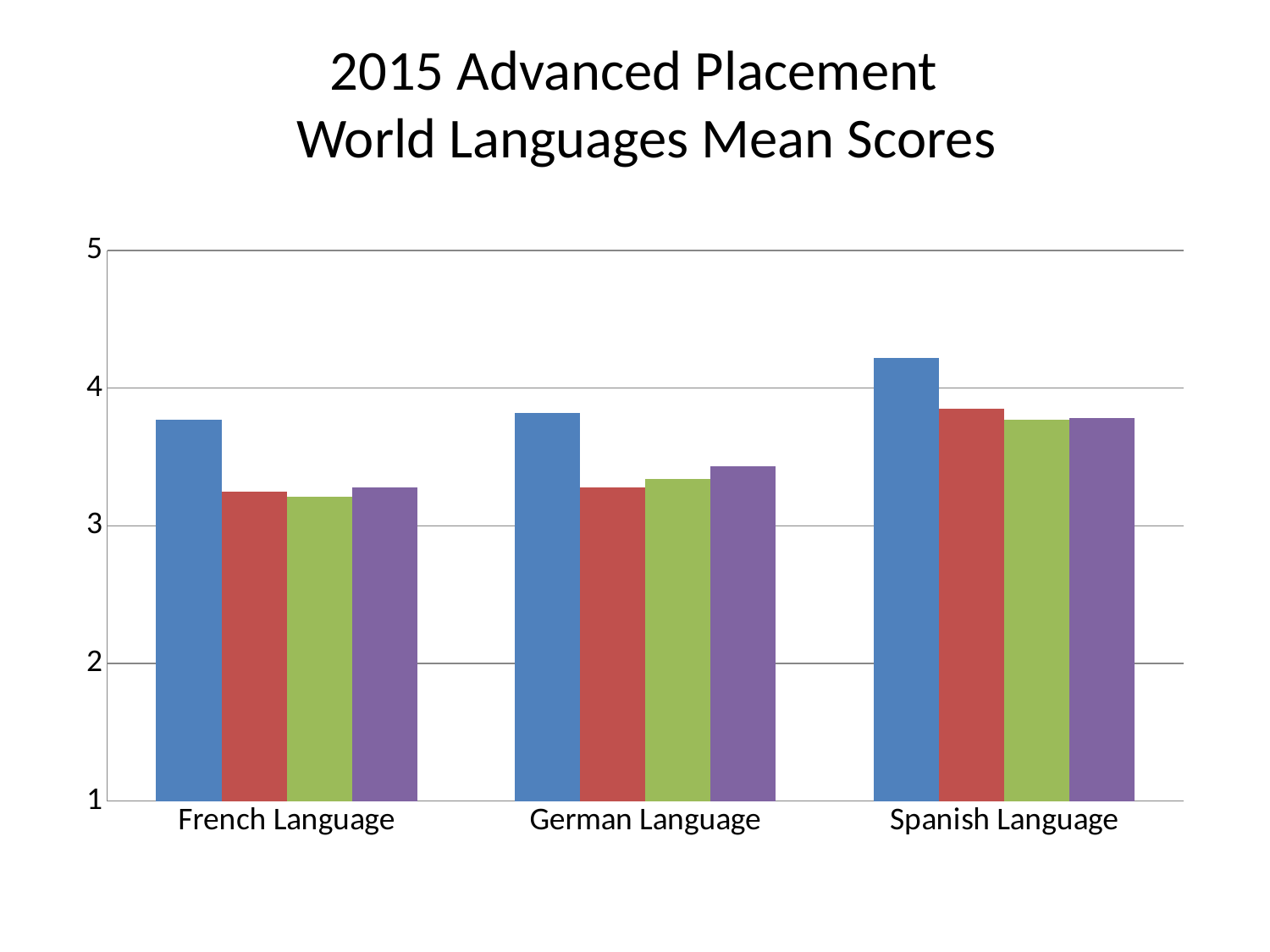
Which language category has the highest blue bar? Spanish Language Is the value of the red bar for German Language greater or less than 3? greater How many language categories are shown on the x axis? 3 Is the value of the blue bar for French Language greater or less than 4? less How many bars are plotted for each language category? 4 What is the title of the chart? 2015 Advanced Placement World Languages Mean Scores Is the value of the blue bar for Spanish Language greater or less than 4? greater What kind of chart is shown on the slide? bar chart For French Language, which is larger, the blue bar or the red bar? the blue bar Which language category has the lowest green bar? French Language Which is larger, the purple bar for Spanish Language or the purple bar for French Language? the purple bar for Spanish Language